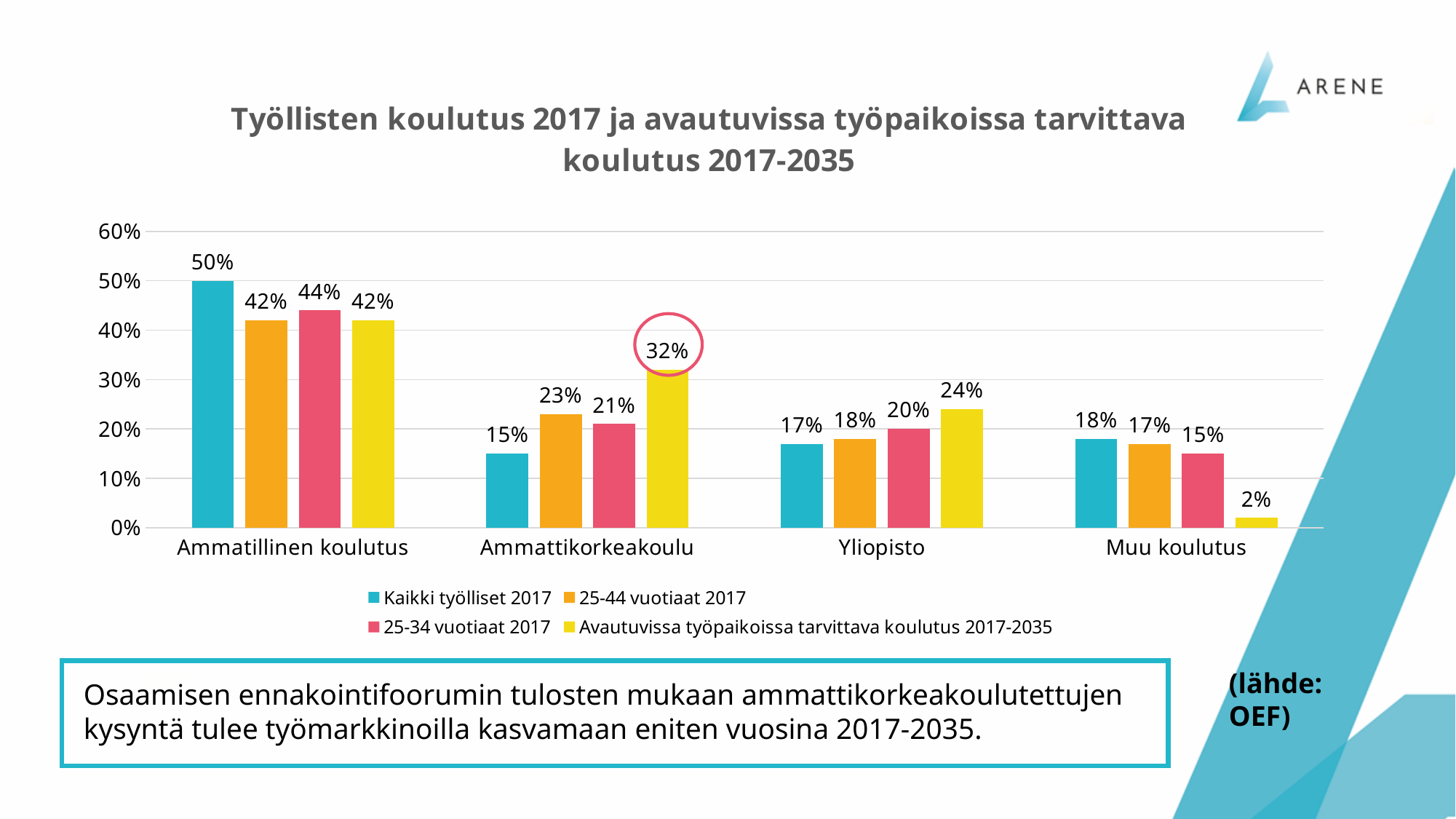
What is the value for Kaikki työlliset 2017 in the Ammatillinen koulutus category? 50% What is the value for 25-34 vuotiaat 2017 in the Yliopisto category? 20% Which series is shown in yellow? Avautuvissa työpaikoissa tarvittava koulutus 2017-2035 In the Yliopisto category, which is larger: the value for 25-44 vuotiaat 2017 or the value for Avautuvissa työpaikoissa tarvittava koulutus 2017-2035? Avautuvissa työpaikoissa tarvittava koulutus 2017-2035 Which category has the lowest value for Avautuvissa työpaikoissa tarvittava koulutus 2017-2035? Muu koulutus What kind of chart is shown on the slide? Bar chart Which category has the highest value for Kaikki työlliset 2017? Ammatillinen koulutus How many categories are shown on the x axis? 4 What is the value for Avautuvissa työpaikoissa tarvittava koulutus 2017-2035 in the Ammattikorkeakoulu category? 32% What is the difference between the Avautuvissa työpaikoissa tarvittava koulutus 2017-2035 value and the Kaikki työlliset 2017 value in the Ammattikorkeakoulu category? 17% How many series does the legend list? 4 What is the value for Avautuvissa työpaikoissa tarvittava koulutus 2017-2035 in the Muu koulutus category? 2%